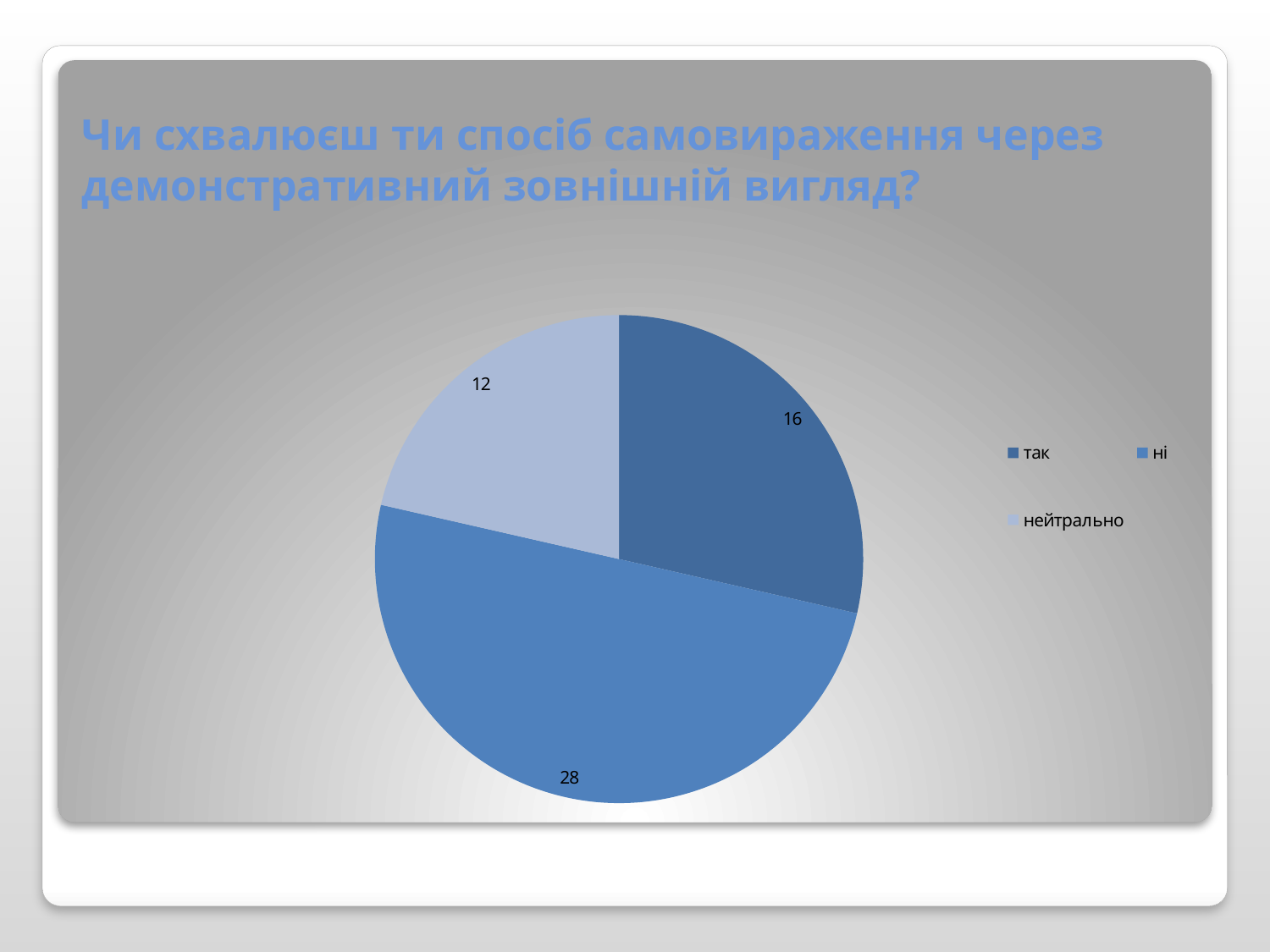
What is the value for "ні" in the pie chart? 28 What is the difference between the values for "так" and "нейтрально"? 4 Which category has the smallest slice in the pie chart? нейтрально What is the value for "так" in the pie chart? 16 What is the total of all slices in the pie chart? 56 Which is larger, the value for "так" or the value for "нейтрально"? так What is the value for "нейтрально" in the pie chart? 12 What type of chart is shown on the slide? pie chart What is the difference between the values for "ні" and "так"? 12 What share of the pie does the "ні" slice represent? 50% How many categories does the pie chart show? 3 Which category has the largest slice in the pie chart? ні